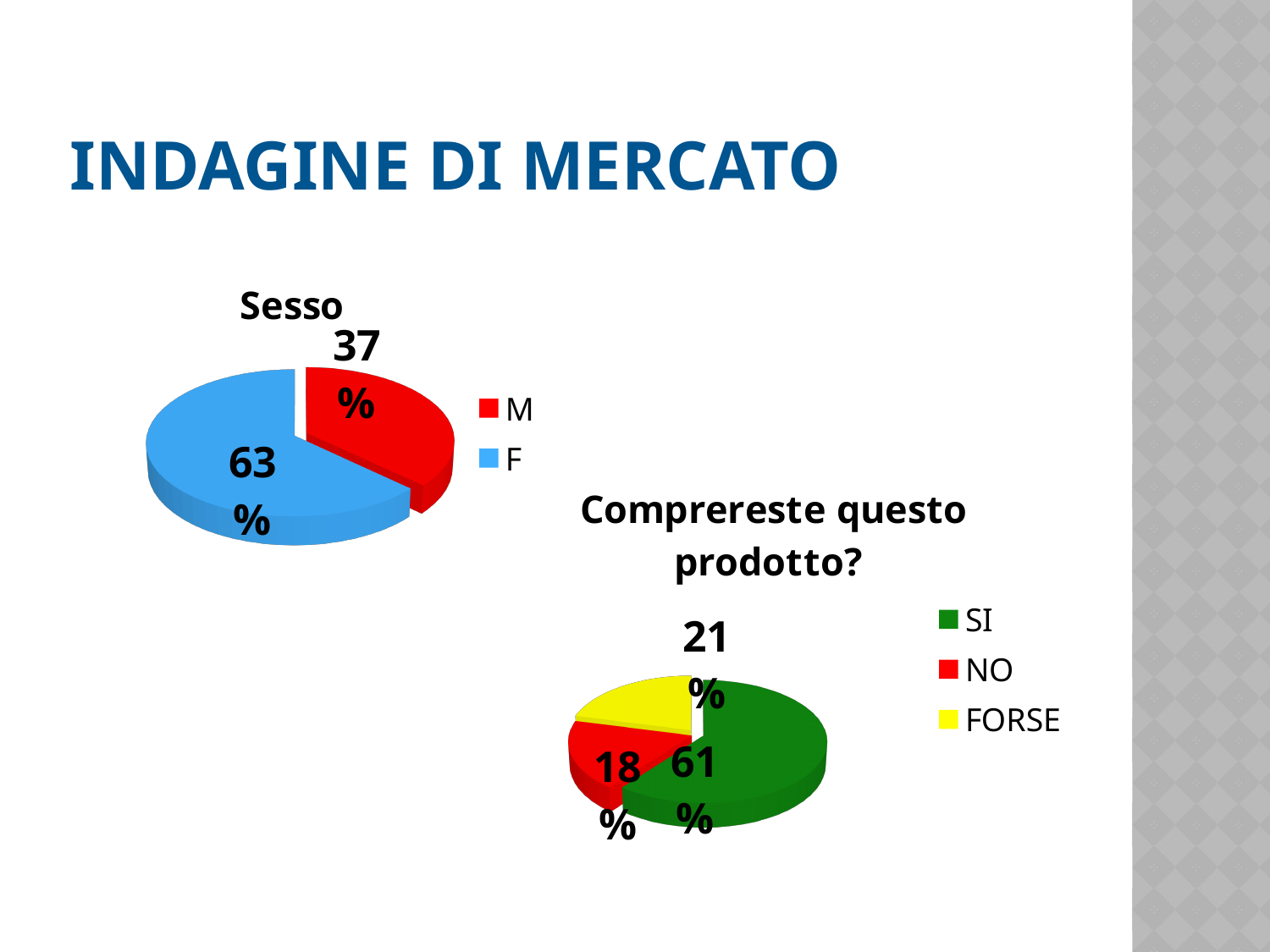
In the 'Sesso' chart, what is the value for M? 37% In the 'Comprereste questo prodotto?' chart, what is the value for NO? 18% In the 'Sesso' chart, which category has the largest share? F In the 'Sesso' chart, what is the value for F? 63% In the 'Comprereste questo prodotto?' chart, what colour is the SI slice? Green In the 'Comprereste questo prodotto?' chart, what is the value for FORSE? 21% What kind of chart is the 'Sesso' chart? Pie chart In the 'Comprereste questo prodotto?' chart, which is larger, FORSE or NO? FORSE In the 'Sesso' chart, how many categories does the legend list? 2 In the 'Comprereste questo prodotto?' chart, what is the value for SI? 61% In the 'Sesso' chart, what is the difference between the F and M shares? 26% In the 'Comprereste questo prodotto?' chart, which category has the smallest share? NO